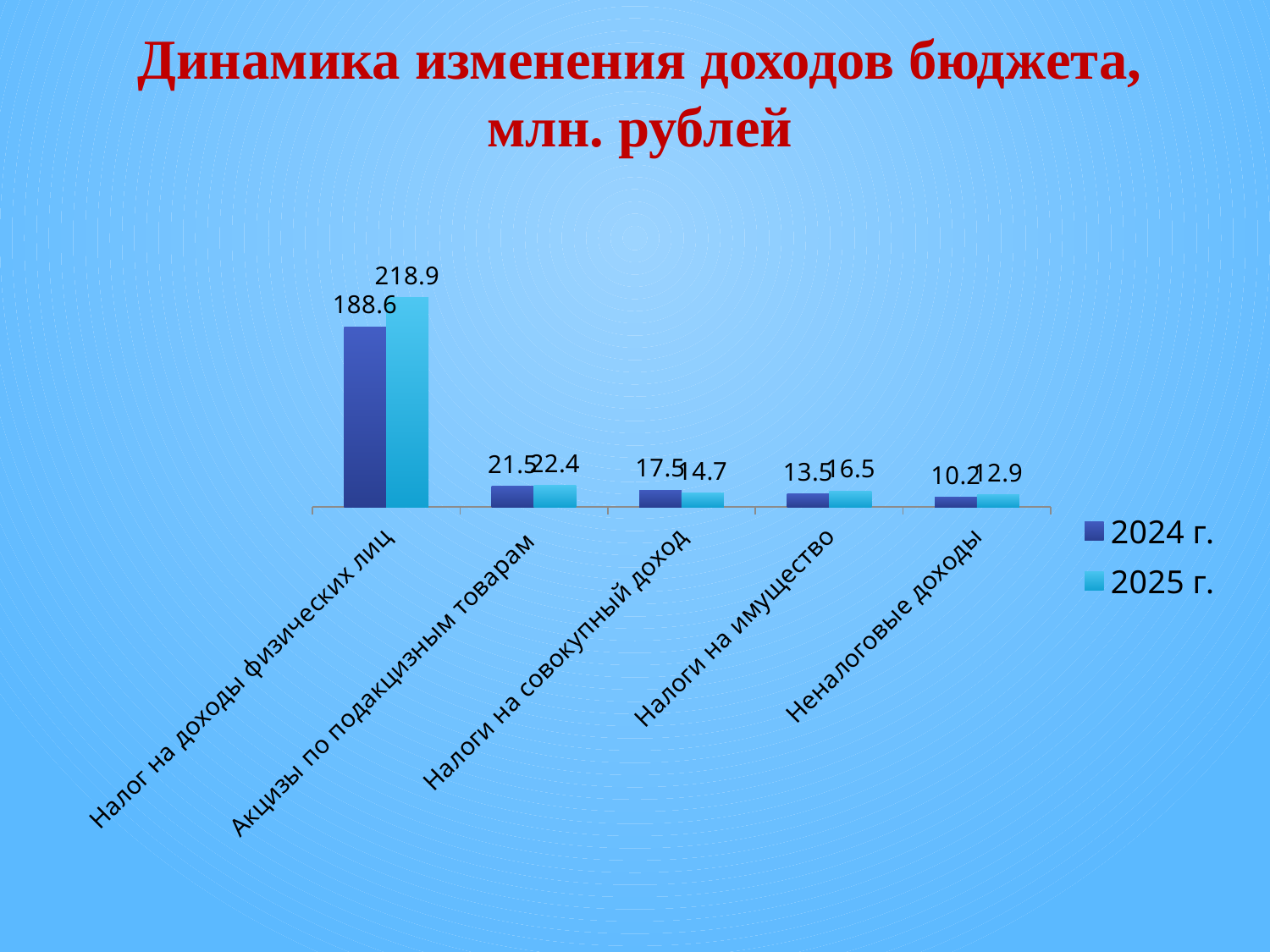
What kind of chart is shown on the slide? Bar chart Which category has the lowest 2024 г. value? Неналоговые доходы How many categories are shown on the x axis? 5 What is the 2024 г. value for Налог на доходы физических лиц? 188.6 What is the title of the chart? Динамика изменения доходов бюджета, млн. рублей How many series does the legend list? 2 What is the 2025 г. value for Налоги на имущество? 16.5 Which category has the highest 2025 г. value? Налог на доходы физических лиц What is the 2024 г. value for Неналоговые доходы? 10.2 For Налоги на совокупный доход, which is larger: the 2024 г. value or the 2025 г. value? 2024 г. What is the difference between the 2025 г. and 2024 г. values for Налог на доходы физических лиц? 30.3 What is the 2025 г. value for Налог на доходы физических лиц? 218.9